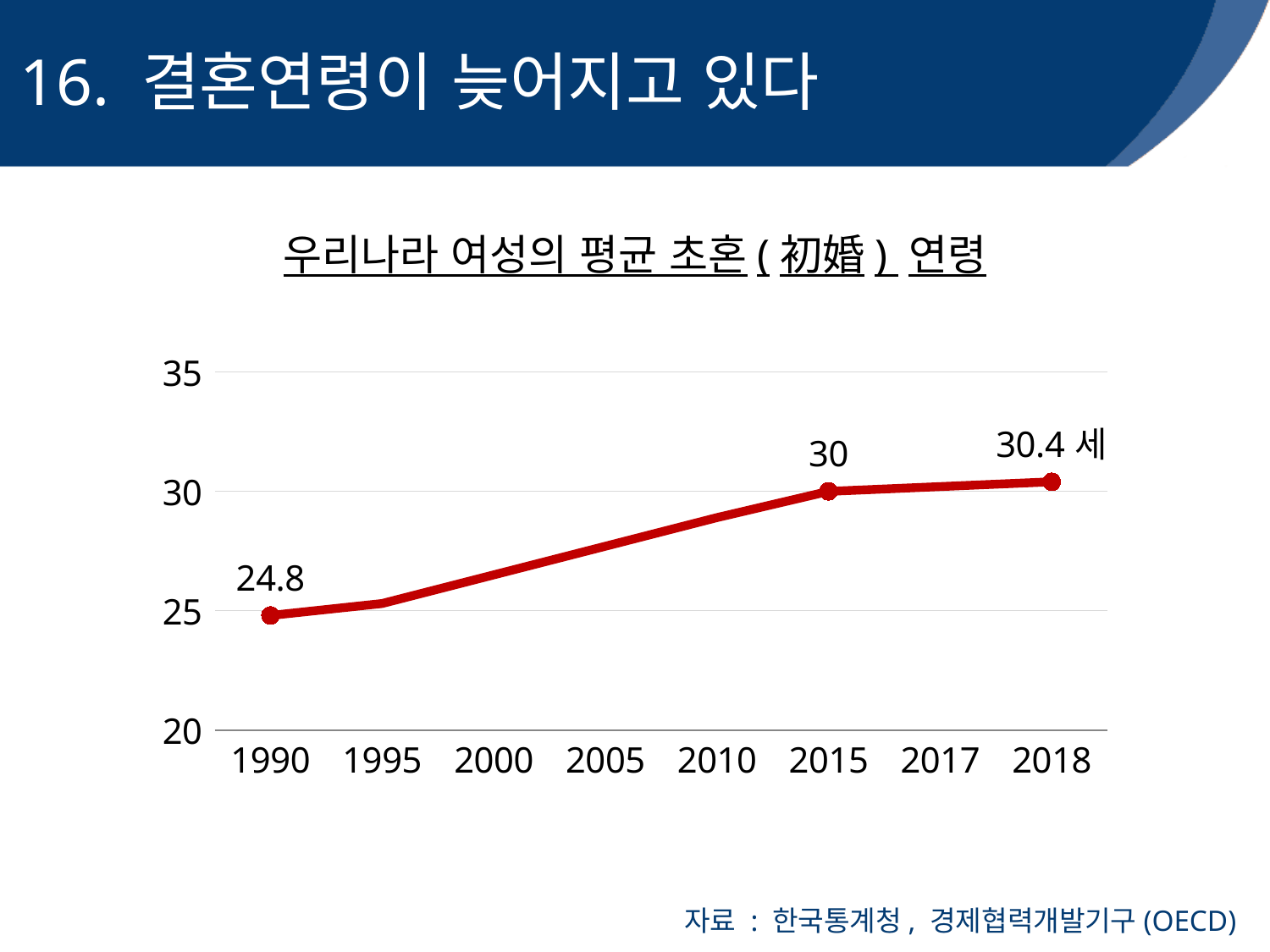
What is the value plotted for 2018? 30.4 세 How many years are shown on the x axis? 8 Is the value for 2005 greater or less than 30? less Which year has the highest value on the chart? 2018 What kind of chart is shown on the slide? line chart Is the value for 2000 greater or less than 25? greater Do the values rise or fall from 1990 to 2018? rise Which year has the lowest value on the chart? 1990 What is the value plotted for 2015? 30 By how much did the value increase from 1990 to 2018? 5.6 What is the difference between the values for 2015 and 1990? 5.2 What is the value plotted for 1990? 24.8